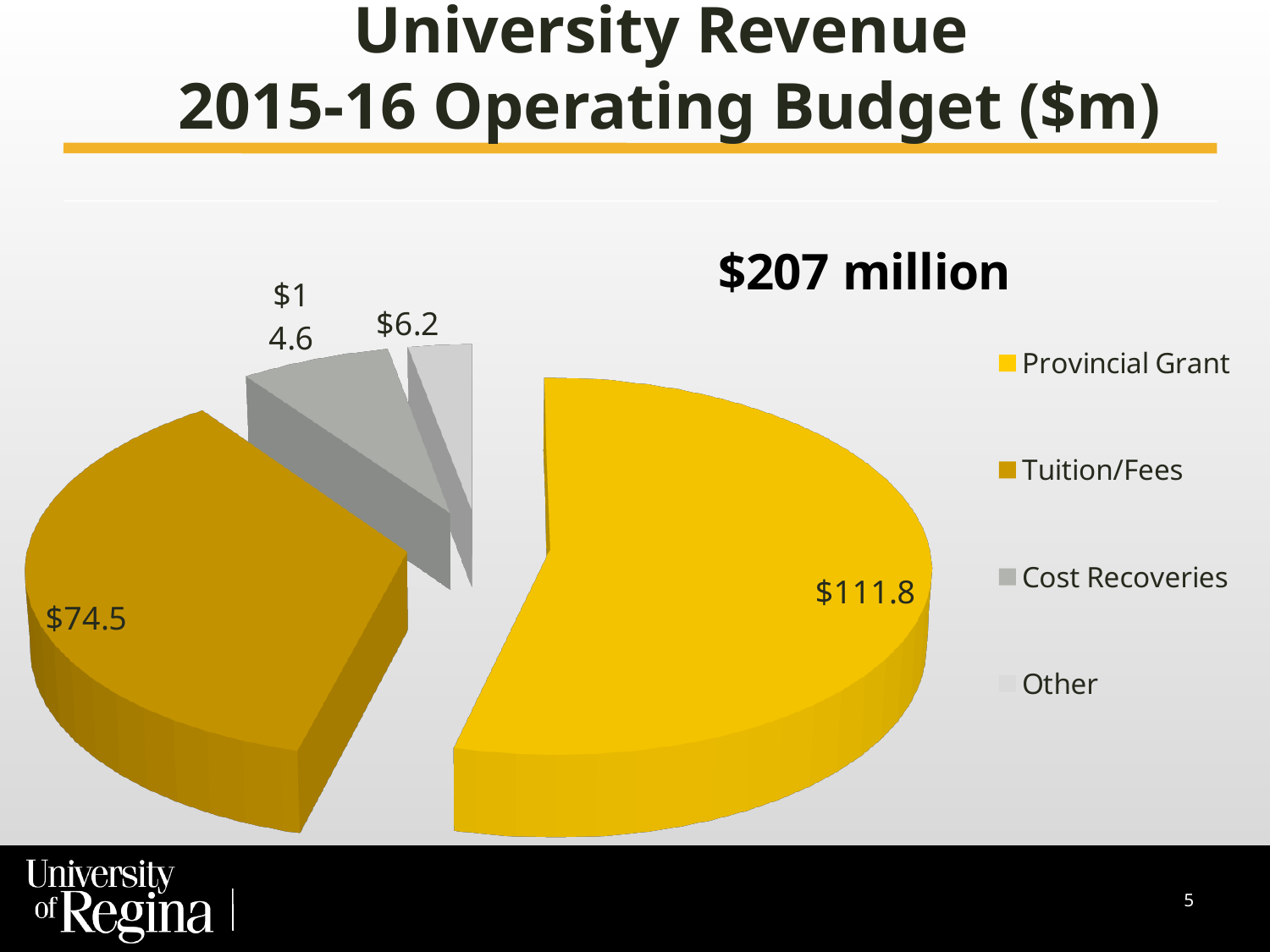
What colour is the Provincial Grant slice? yellow What is the difference between the Provincial Grant and Tuition/Fees values? $37.3 What is the value shown for Tuition/Fees? $74.5 How many slices does the pie chart have? 4 What is the value shown for Other? $6.2 Which revenue category is the largest? Provincial Grant What is the value shown for Provincial Grant? $111.8 What total revenue figure is stated next to the pie chart? $207 million Which is larger, Cost Recoveries or Other? Cost Recoveries Which is larger, Tuition/Fees or Other? Tuition/Fees What kind of chart is shown on the slide? pie chart Which revenue category is the smallest? Other